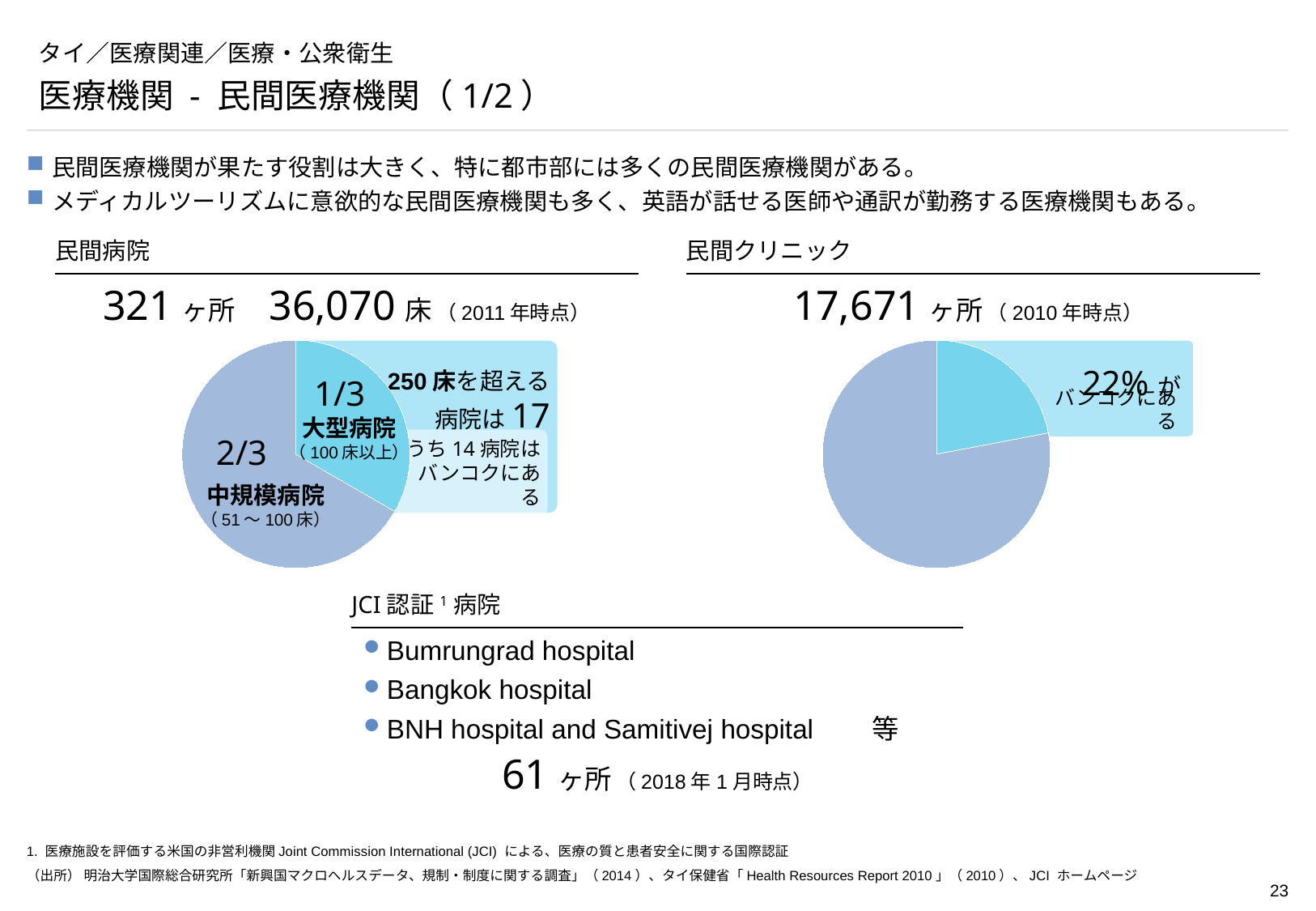
In the 民間病院 pie chart, what share is labelled 中規模病院? 2/3 In the 民間病院 pie chart, what bed threshold is given in parentheses for 大型病院? 100床以上 In the 民間クリニック pie chart, is the Bangkok slice larger or smaller than the remaining slice? smaller What kind of chart is shown under the 民間クリニック heading? pie chart In the 民間病院 pie chart, what bed range is given in parentheses for 中規模病院? 51～100床 In the 民間クリニック pie chart, what share of clinics is labelled as being in Bangkok (バンコクにある)? 22% In the 民間病院 pie chart, what share is labelled 大型病院? 1/3 In the 民間病院 pie chart, which slice is larger, 大型病院 or 中規模病院? 中規模病院 How many slices does the 民間病院 pie chart have? 2 How many slices does the 民間クリニック pie chart have? 2 In the 民間病院 pie chart, which category has the largest slice? 中規模病院 What kind of chart is shown under the 民間病院 heading? pie chart